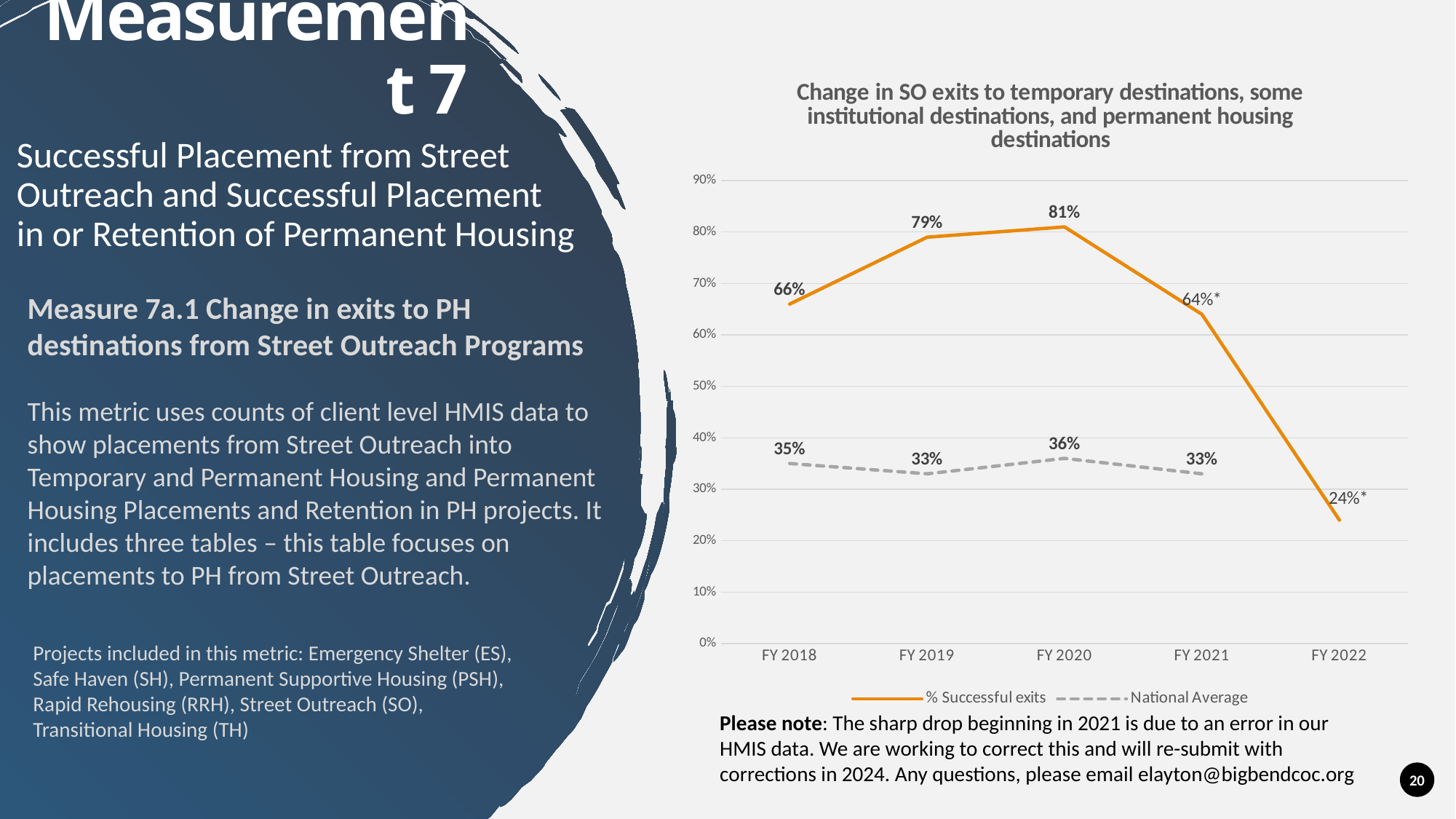
Is the value of % Successful exits for FY 2018 greater or less than 60%? greater How many fiscal years are shown on the x axis? 5 In which fiscal year is % Successful exits highest? FY 2020 In which fiscal year is % Successful exits lowest? FY 2022 Which is larger in FY 2021, % Successful exits or the National Average? % Successful exits What is the National Average value for FY 2018? 35% Does the % Successful exits line rise or fall from FY 2020 to FY 2022? Fall How many series does the legend list? 2 What type of chart is shown on the slide? Line chart What is the value of % Successful exits for FY 2020? 81% What is the difference between % Successful exits and the National Average in FY 2019? 46 percentage points What is the value of % Successful exits for FY 2022? 24%*